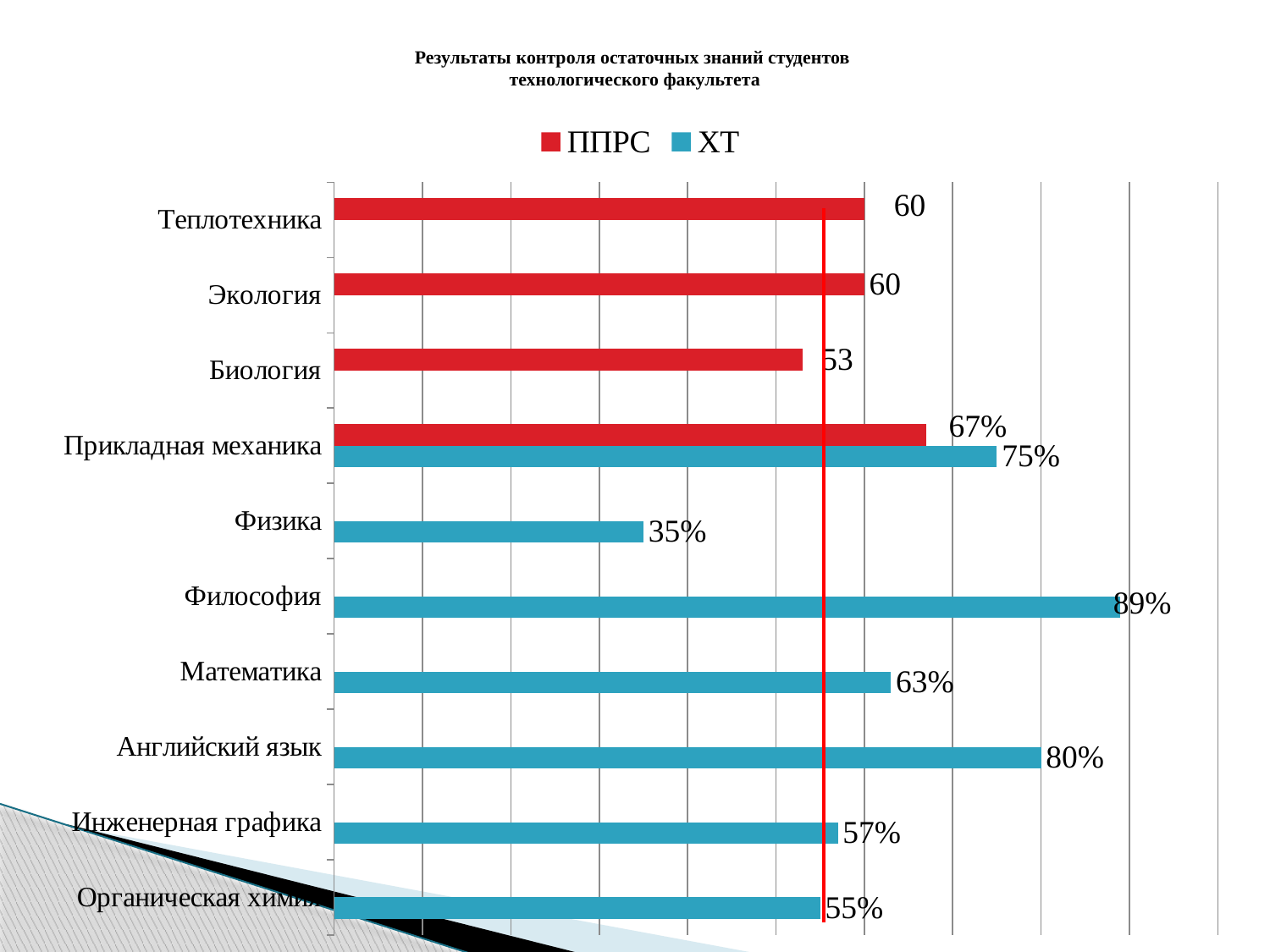
Which category has the highest ХТ value? Философия Which has the larger ХТ value, Английский язык or Математика? Английский язык What is the ППРС value for Прикладная механика? 67% Which category has the lowest ХТ value? Физика What kind of chart is shown on the slide? Bar chart What is the ХТ value for Физика? 35% How many series does the legend list? 2 What is the ХТ value for Философия? 89% What is the ХТ value for Инженерная графика? 57% What are the two series named in the legend? ППРС and ХТ For Прикладная механика, what is the difference between the ХТ value and the ППРС value? 8 percentage points What is the ППРС value for Биология? 53